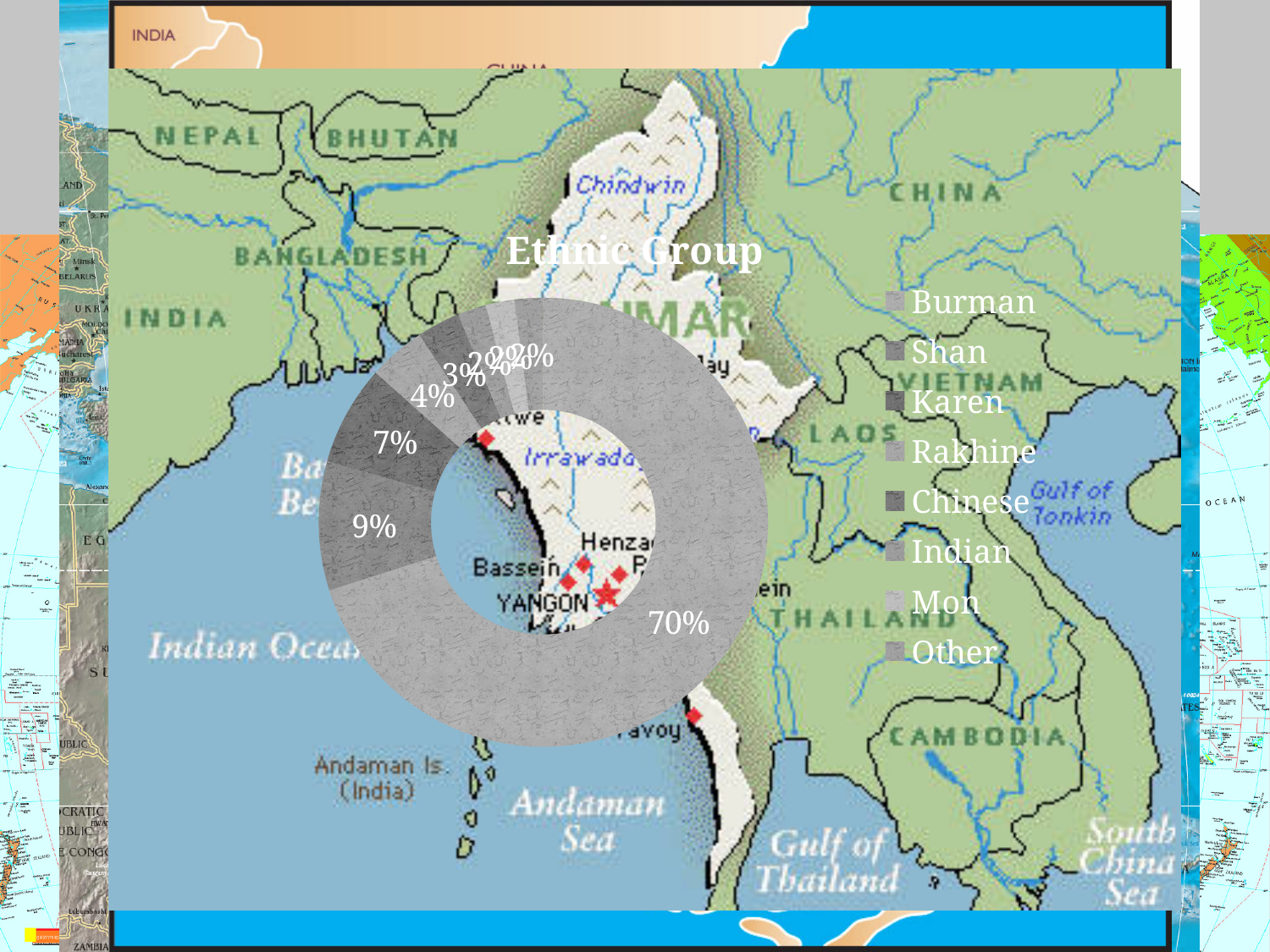
What is the difference between the Shan share and the Karen share? 2 percentage points Which ethnic group has the largest share in the chart? Burman What is the title of the chart on the slide? Ethnic Group Which is larger in the chart, the share for Shan or the share for Karen? Shan What is the value shown for Rakhine in the chart? 4% What is the value shown for Chinese in the chart? 3% What kind of chart is shown on the slide? doughnut chart By how many percentage points does the Burman share exceed the Shan share? 61 percentage points What is the value shown for Karen in the chart? 7% How many ethnic groups does the legend of the chart list? 8 What share of the chart does Burman account for? 70% What is the value shown for Shan in the chart? 9%